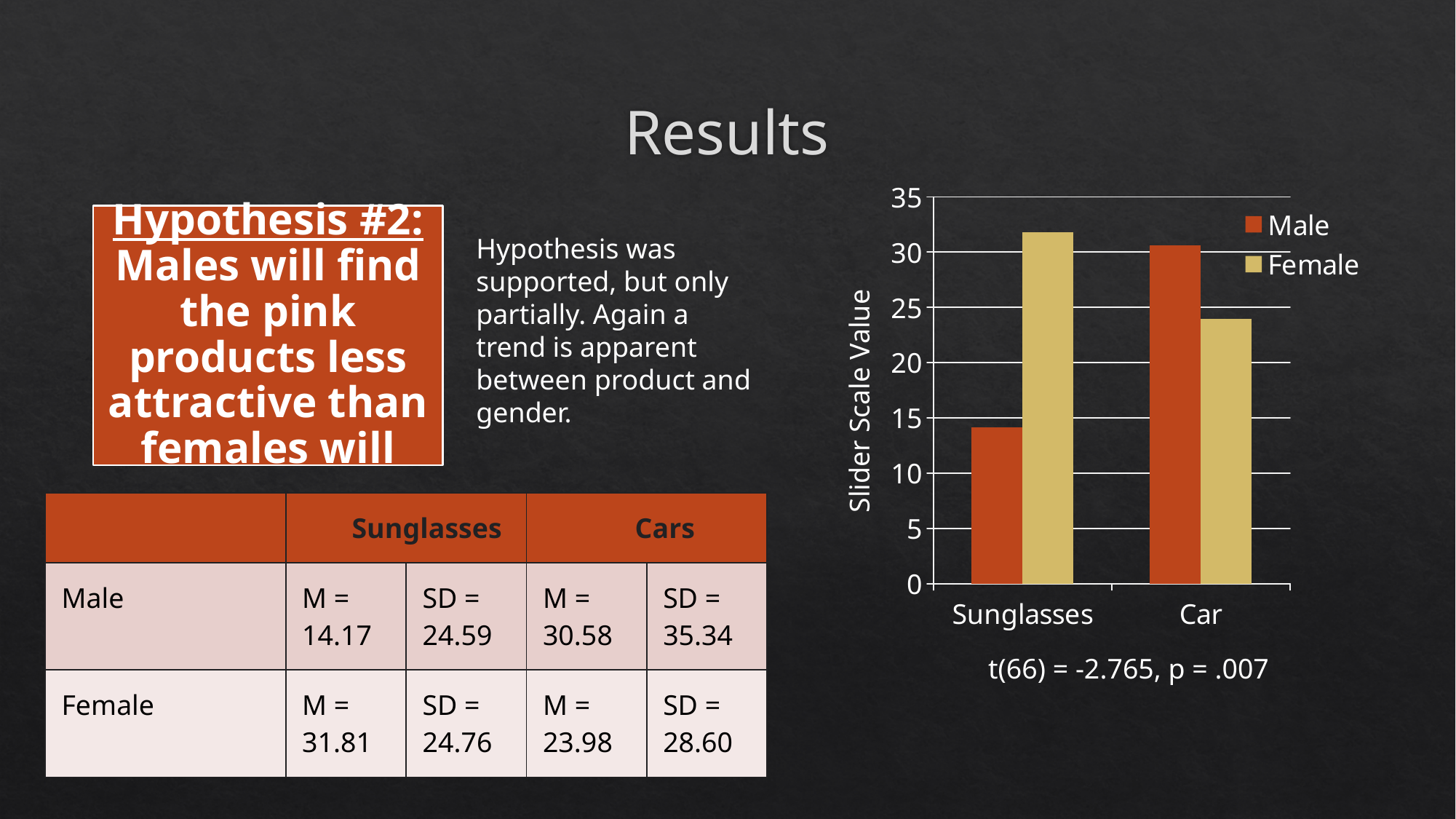
What is the label of the y axis of the chart? Slider Scale Value Which bar in the chart is the lowest? Male, Sunglasses For Car, which series has the larger value, Male or Female? Male Is the Female value for Car greater or less than 25? less What kind of chart is shown on the slide? bar chart Which series is shown in the yellow/tan colour in the chart? Female For Sunglasses, which series has the larger value, Male or Female? Female Is the Female value for Sunglasses greater or less than 30? greater Is the Male value for Sunglasses greater or less than 15? less How many series does the chart legend list? 2 How many categories are shown on the x axis of the chart? 2